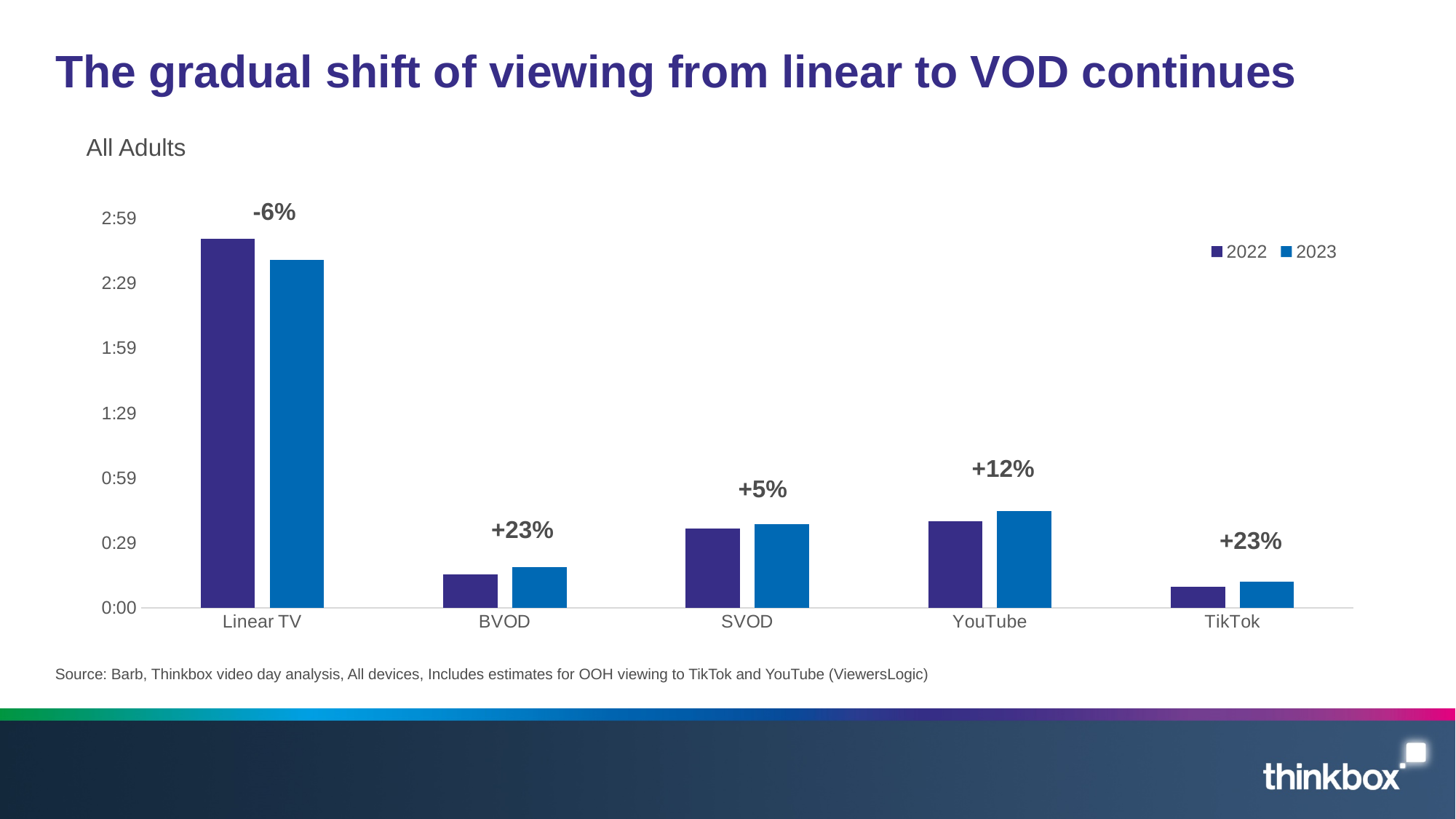
Is the 2023 value for Linear TV greater or less than 2:29? greater Which category has the highest viewing time in the chart? Linear TV What percentage change is labelled above the SVOD bars? +5% What kind of chart is shown on the slide? bar chart How many categories are shown on the x axis of the chart? 5 What percentage change is labelled above the YouTube bars? +12% For Linear TV, which is larger: the 2022 value or the 2023 value? 2022 What percentage change is labelled above the BVOD bars? +23% Is the 2022 value for BVOD greater or less than 0:29? less What percentage change is labelled above the Linear TV bars? -6% How many series does the chart's legend list? 2 Which category has the lowest 2022 viewing time in the chart? TikTok